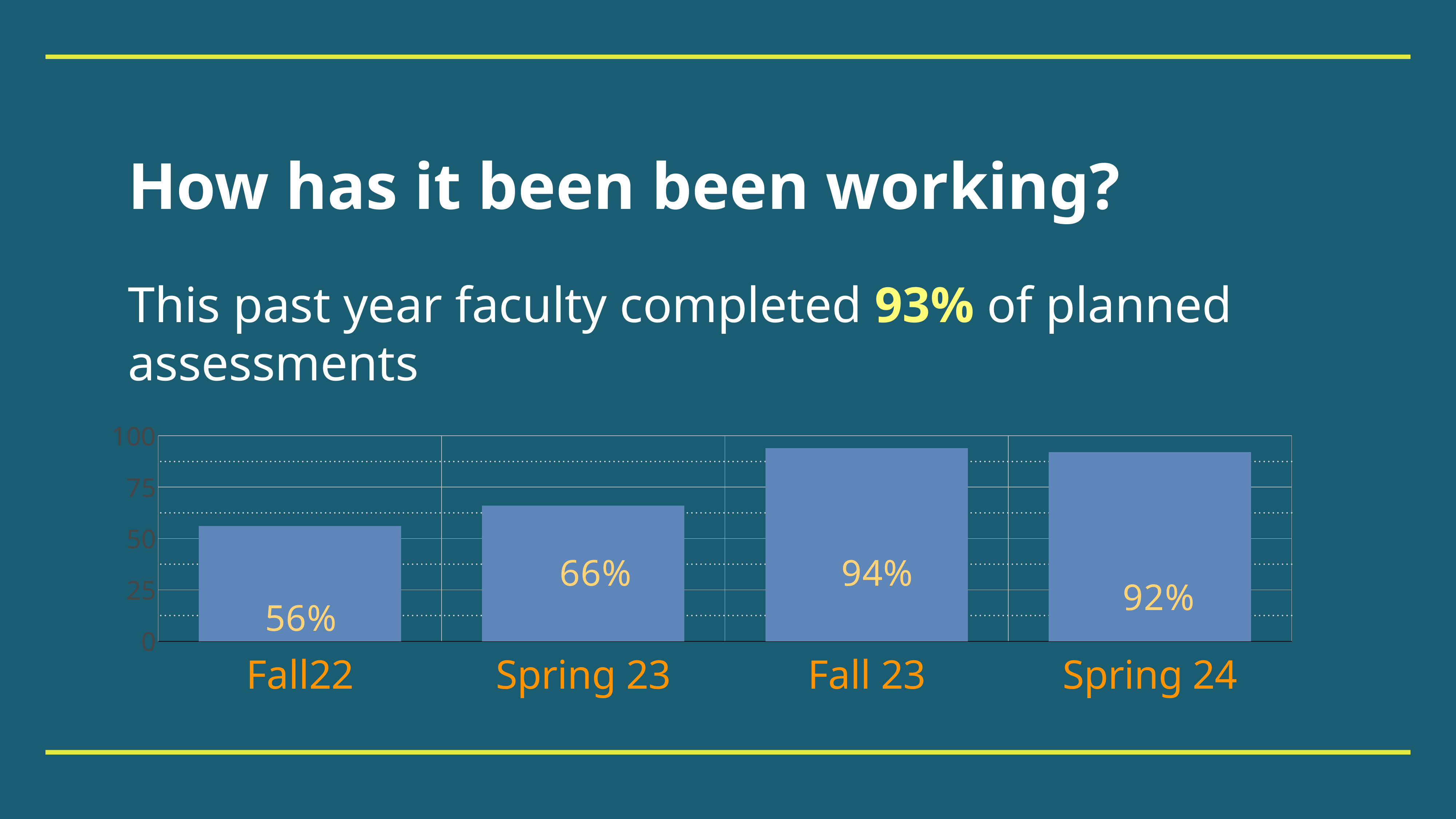
What is the value for Fall22? 56% What is the value for Fall 23? 94% Which is larger, the value for Spring 23 or the value for Spring 24? Spring 24 What is the difference between the values for Spring 24 and Spring 23? 26% What is the difference between the values for Fall 23 and Fall22? 38% What is the value for Spring 23? 66% What is the value for Spring 24? 92% What kind of chart is shown on the slide? Bar chart Which category has the highest value? Fall 23 Which category has the lowest value? Fall22 How many categories are shown on the x axis? 4 Do the values generally rise or fall from Fall22 to Fall 23? Rise